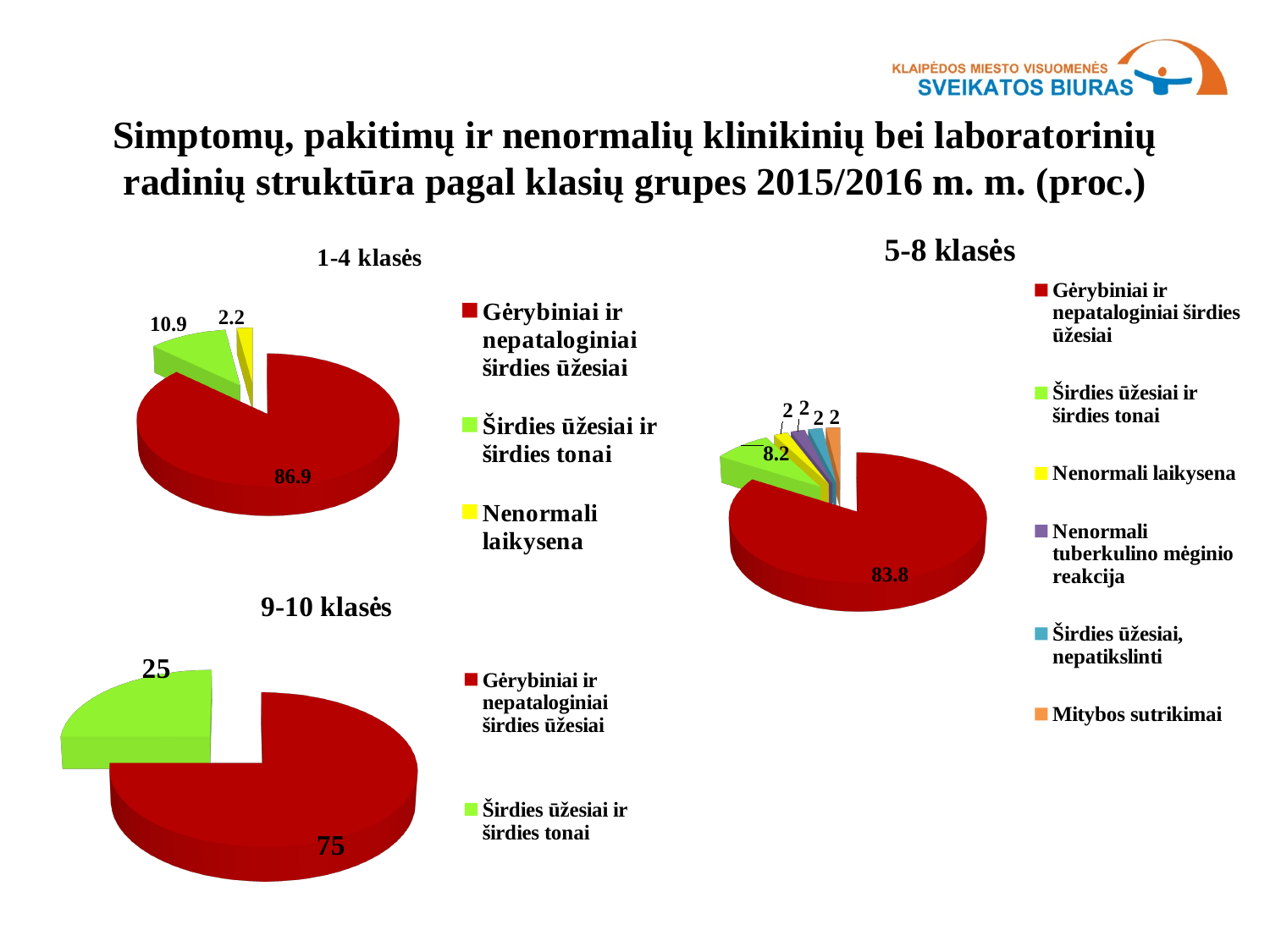
In the 1-4 klasės chart, which category has the smallest slice? Nenormali laikysena In the 9-10 klasės chart, what is the value for Širdies ūžesiai ir širdies tonai? 25 In the 1-4 klasės chart, what is the value for Gėrybiniai ir nepatologiniai širdies ūžesiai? 86.9 What kind of chart is the 1-4 klasės chart? Pie chart In the 1-4 klasės chart, what is the value for Nenormali laikysena? 2.2 In the 9-10 klasės chart, which category has the largest slice? Gėrybiniai ir nepatologiniai širdies ūžesiai How many categories does the legend of the 5-8 klasės chart list? 6 In the 9-10 klasės chart, what is the difference between the values for Gėrybiniai ir nepatologiniai širdies ūžesiai and Širdies ūžesiai ir širdies tonai? 50 In the 5-8 klasės chart, what is the value for Širdies ūžesiai ir širdies tonai? 8.2 In the 5-8 klasės chart, what is the value for Mitybos sutrikimai? 2 In the 1-4 klasės chart, what is the value for Širdies ūžesiai ir širdies tonai? 10.9 In the 5-8 klasės chart, what is the value for Gėrybiniai ir nepatologiniai širdies ūžesiai? 83.8